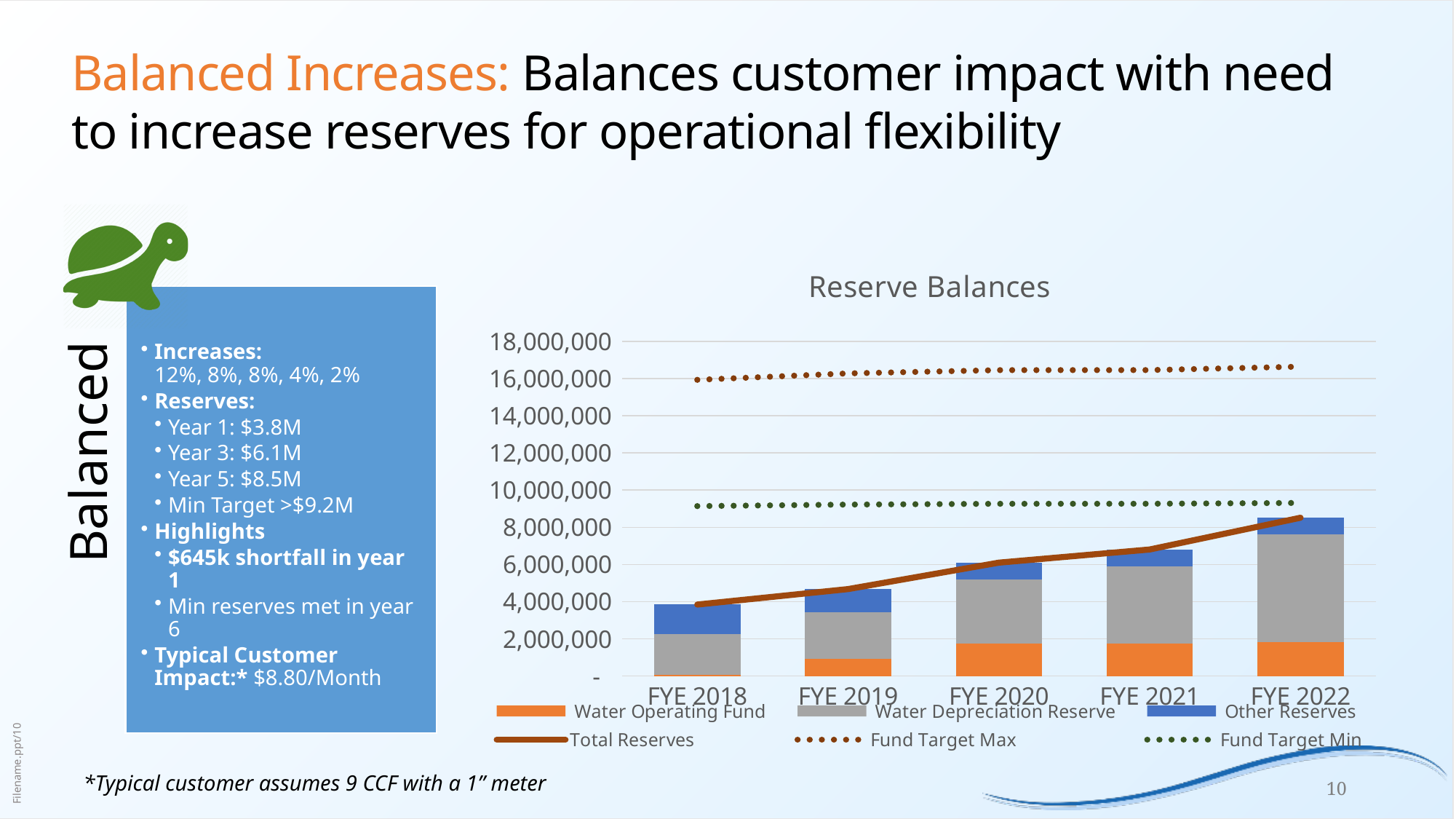
How many series does the legend of the Reserve Balances chart list? 6 Which is larger in the Reserve Balances chart: the total reserves for FYE 2021 or for FYE 2019? FYE 2021 Which fiscal year has the highest total reserves in the Reserve Balances chart? FYE 2022 Is the total reserves value for FYE 2018 greater or less than 4,000,000? less Do total reserves rise or fall from FYE 2018 to FYE 2022 in the Reserve Balances chart? Rise What kind of chart is the Reserve Balances chart? Stacked bar chart with line series Which fiscal year has the lowest total reserves in the Reserve Balances chart? FYE 2018 Is the Fund Target Min line greater or less than 10,000,000? less Is the Fund Target Max line greater or less than 14,000,000? greater How many fiscal years are shown on the x axis of the Reserve Balances chart? 5 What is the title of the chart on the slide? Reserve Balances